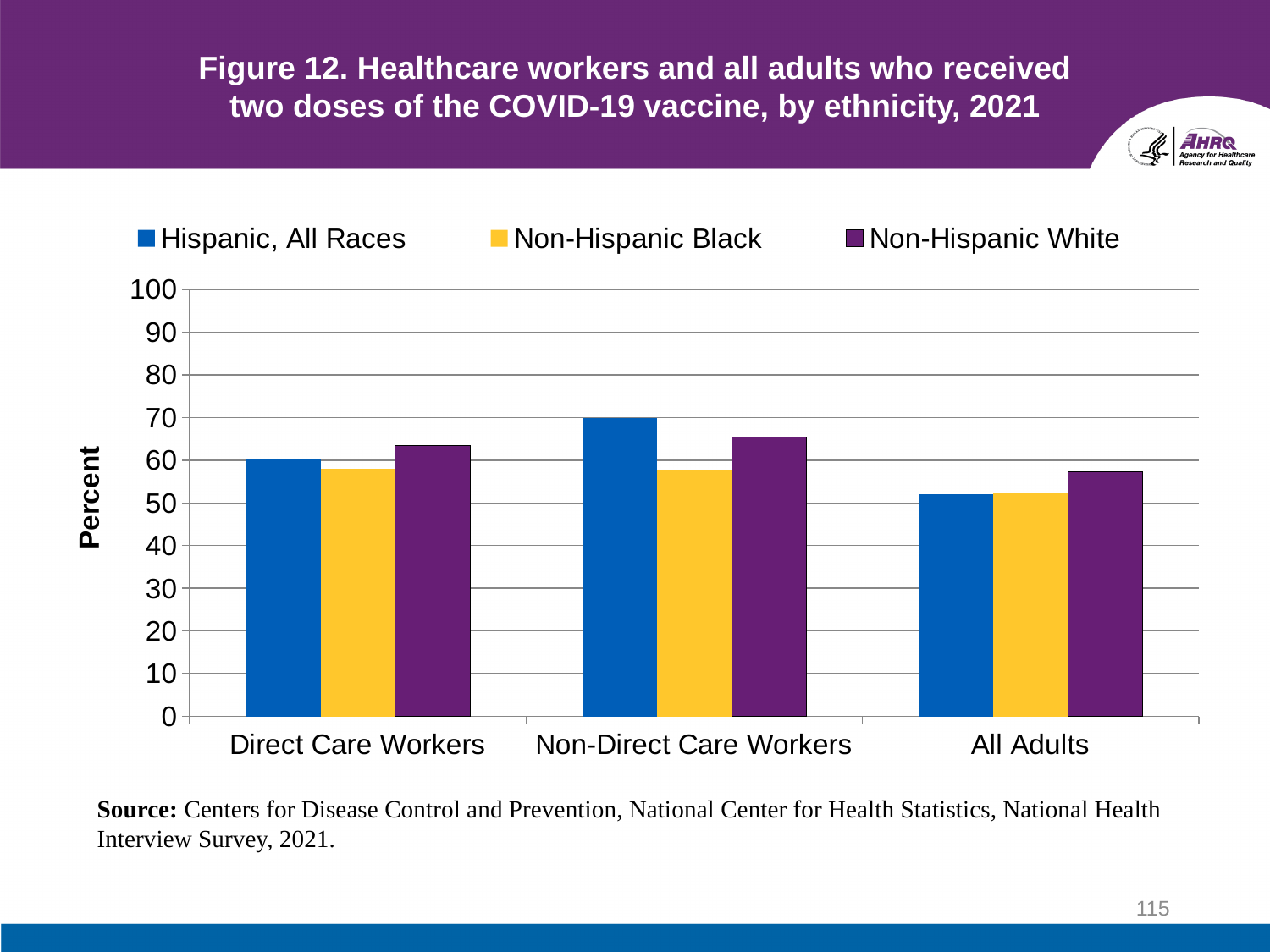
What is the label on the y axis? Percent What kind of chart is shown on the slide? bar chart Among Direct Care Workers, which is larger: the value for Non-Hispanic White or for Non-Hispanic Black? Non-Hispanic White For the Non-Hispanic White series, which category has the lowest value? All Adults Is the value for Non-Hispanic Black among Direct Care Workers greater or less than 50? greater For the Hispanic, All Races series, which category has the highest value? Non-Direct Care Workers Is the value for Hispanic, All Races among All Adults greater or less than 60? less Is the value for Hispanic, All Races among Non-Direct Care Workers greater or less than 60? greater Among Non-Direct Care Workers, which ethnicity group has the highest value? Hispanic, All Races How many categories are shown on the x axis? 3 How many series does the legend list? 3